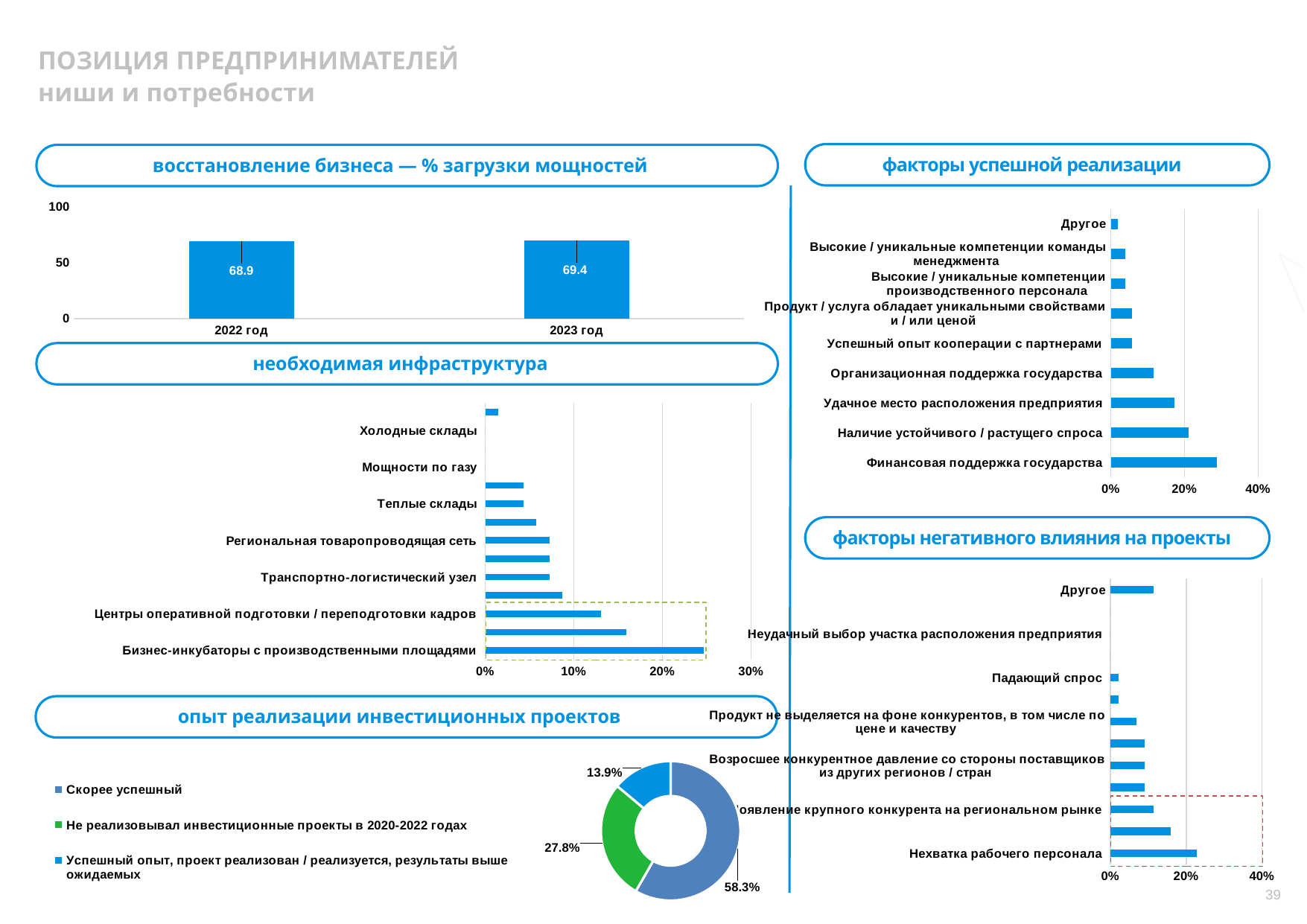
In the chart 'опыт реализации инвестиционных проектов', what share is 'Скорее успешный'? 58.3% In the chart 'факторы успешной реализации', which factor has the lowest value? Другое What kind of chart is 'восстановление бизнеса — % загрузки мощностей'? Bar chart In the chart 'восстановление бизнеса — % загрузки мощностей', what is the difference between the 2023 год and 2022 год values? 0.5 In the chart 'факторы успешной реализации', is the value for 'Организационная поддержка государства' greater or less than 20%? less In the chart 'опыт реализации инвестиционных проектов', what is the difference between the 'Скорее успешный' share and the 'Успешный опыт, проект реализован / реализуется, результаты выше ожидаемых' share? 44.4% How many entries does the legend of the chart 'опыт реализации инвестиционных проектов' list? 3 In the chart 'факторы успешной реализации', which factor has the highest value? Финансовая поддержка государства In the chart 'факторы успешной реализации', is the value for 'Финансовая поддержка государства' greater or less than 20%? greater In the chart 'восстановление бизнеса — % загрузки мощностей', what is the value for 2022 год? 68.9 In the chart 'восстановление бизнеса — % загрузки мощностей', what is the value for 2023 год? 69.4 In the chart 'факторы успешной реализации', how many factors are listed? 9